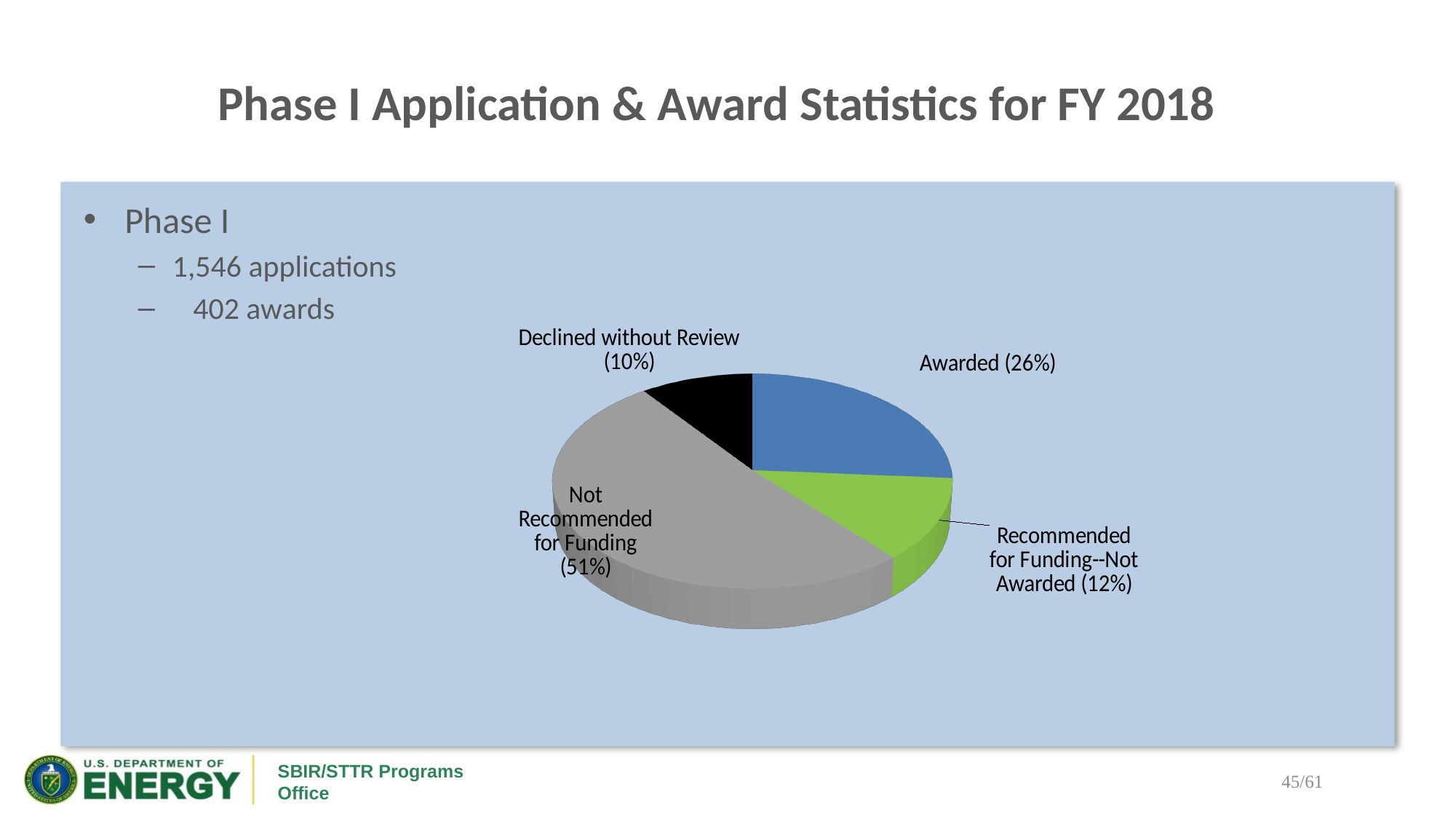
Which is larger, the Awarded slice or the Recommended for Funding--Not Awarded slice? Awarded What share of the pie is labelled Awarded? 26% What is the difference in percentage points between the Not Recommended for Funding slice and the Awarded slice? 25 What kind of chart is shown on the slide? Pie chart What share of the pie is labelled Recommended for Funding--Not Awarded? 12% What colour is the Awarded slice of the pie? Blue Which slice of the pie is the largest? Not Recommended for Funding What share of the pie is labelled Declined without Review? 10% What colour is the Declined without Review slice of the pie? Black How many slices does the pie chart have? 4 Which slice of the pie is the smallest? Declined without Review